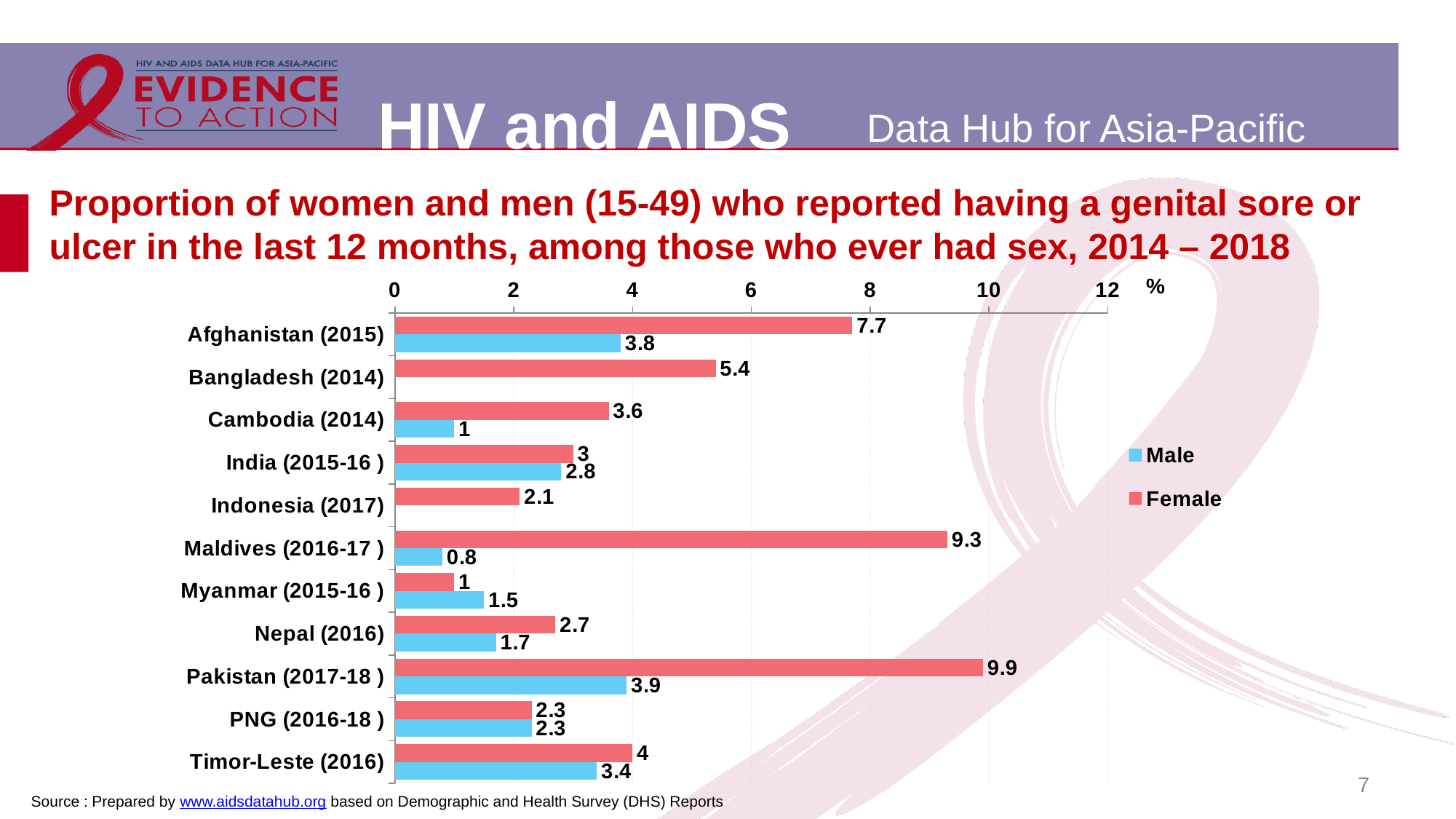
Which country has the highest Female value? Pakistan (2017-18) Which country has the lowest Male value? Maldives (2016-17) What colour represents the Female series? Red Is the Female value for Afghanistan (2015) greater or less than 6? greater What is the Male value for Afghanistan (2015)? 3.8 How many series does the legend list? 2 What is the difference between the Female and Male values for Maldives (2016-17)? 8.5 How many countries are shown on the chart? 11 What is the Female value for Pakistan (2017-18)? 9.9 What kind of chart is shown on the slide? Bar chart What is the Female value for Maldives (2016-17)? 9.3 Which is larger for Myanmar (2015-16), the Male value or the Female value? Male